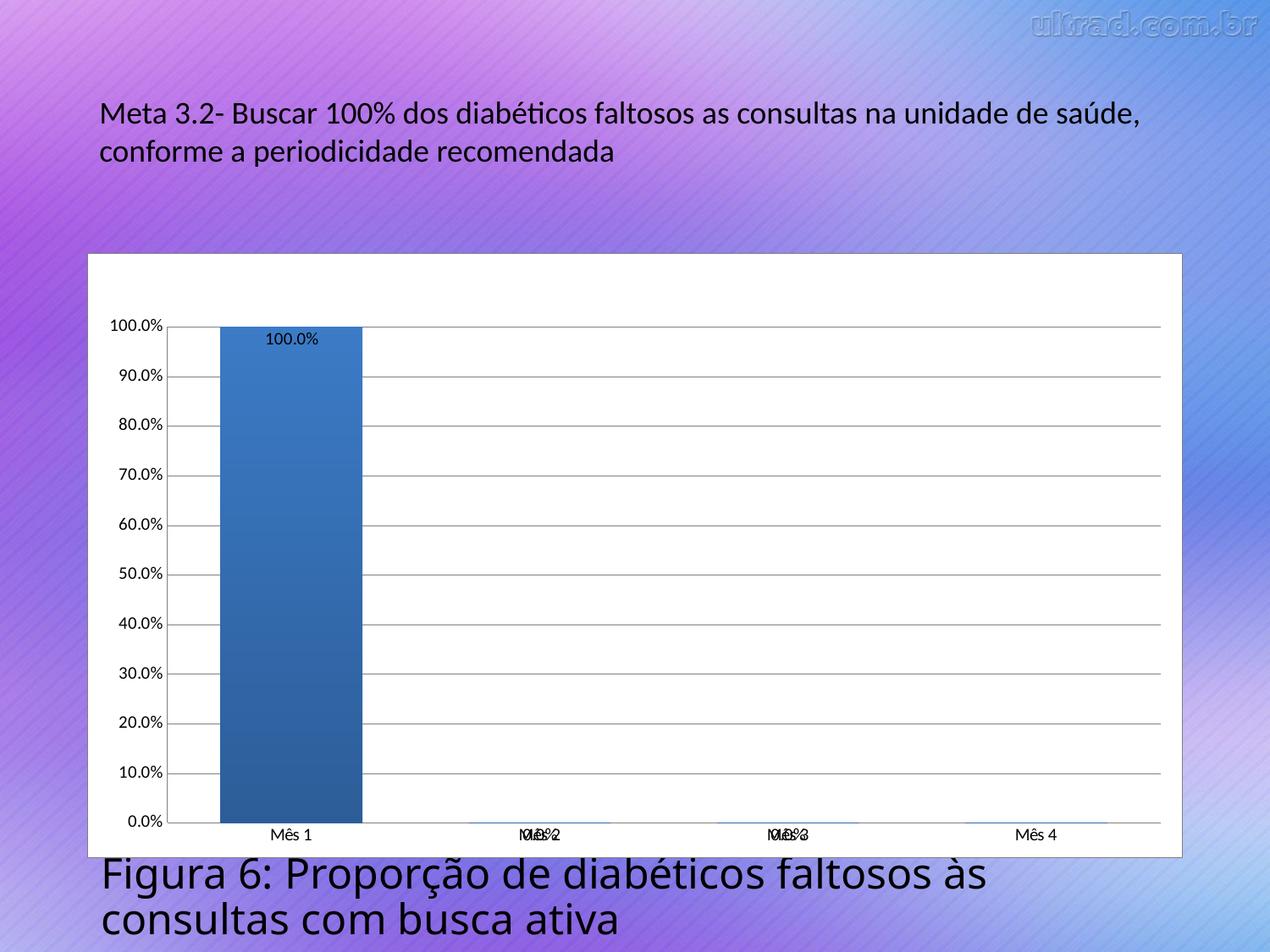
What is the value for Mês 2? 0.0% What is the difference between the values for Mês 1 and Mês 3? 100.0% Which month has the highest value? Mês 1 Is the value for Mês 4 greater or less than 50.0%? less Which is larger, the value for Mês 1 or the value for Mês 2? Mês 1 Is the value for Mês 1 greater or less than 90.0%? greater Do the values rise or fall from Mês 1 to Mês 4? fall What is the figure caption below the chart? Figura 6: Proporção de diabéticos faltosos às consultas com busca ativa What kind of chart is shown on the slide? Bar chart What is the highest tick shown on the y axis? 100.0% How many months are shown on the x axis? 4 What is the value for Mês 1? 100.0%